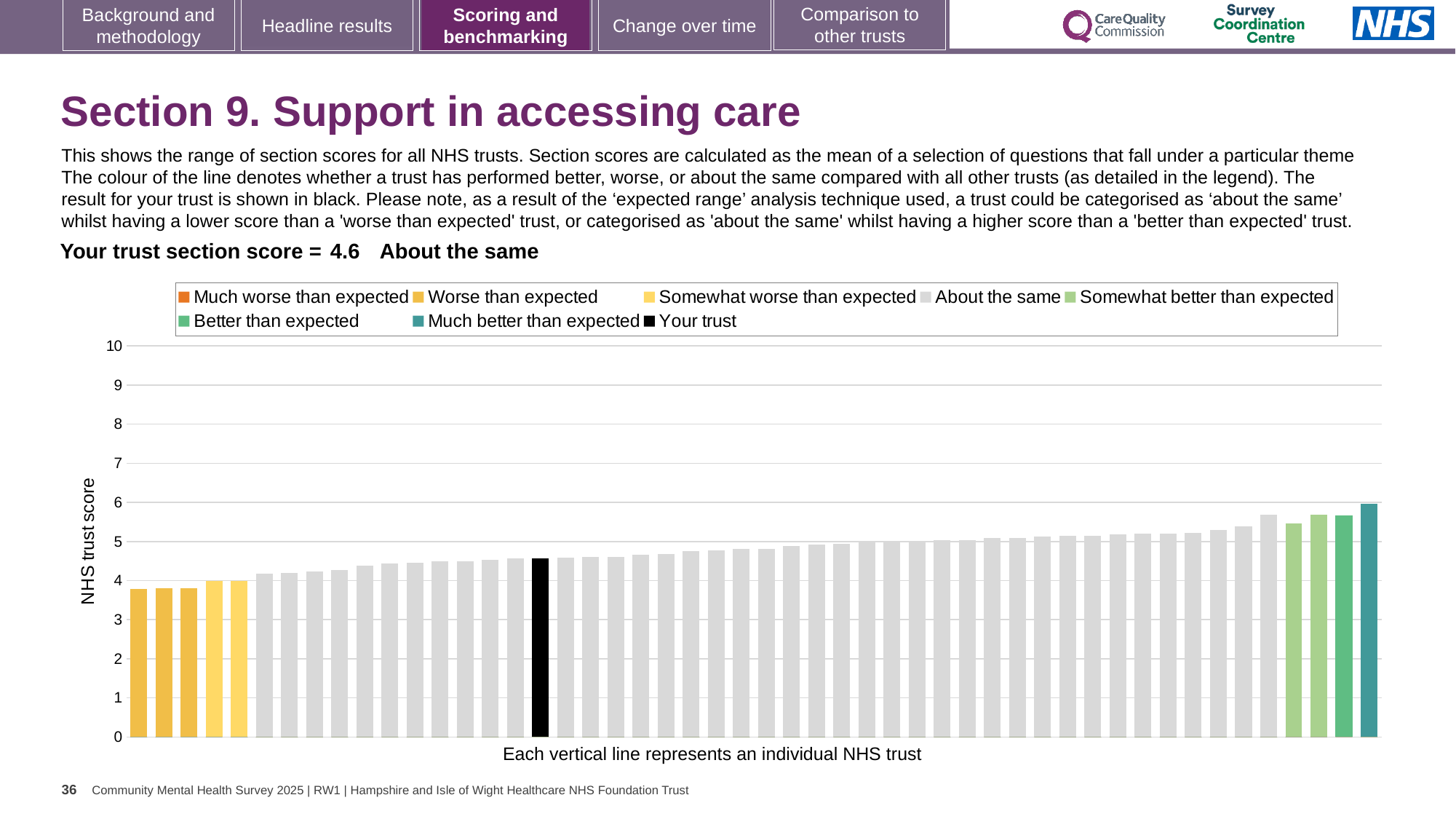
Do the bar values rise or fall from left to right along the x axis? rise Is the value of the tallest bar (Much better than expected) greater or less than 5? greater Which is larger: the 'Much better than expected' bar or the 'Your trust' bar? Much better than expected What is the label on the vertical axis of the chart? NHS trust score Is the value of the shortest bar on the chart greater or less than 4? less How many bars are coloured as 'Much better than expected'? 1 What kind of chart is shown on the slide? bar chart How many entries does the chart legend list? 8 Is the value of the black 'Your trust' bar greater or less than 4? greater Which category is your trust's section score placed in? About the same Which legend category does the tallest bar on the chart belong to? Much better than expected What is the section score for your trust shown on the slide? 4.6